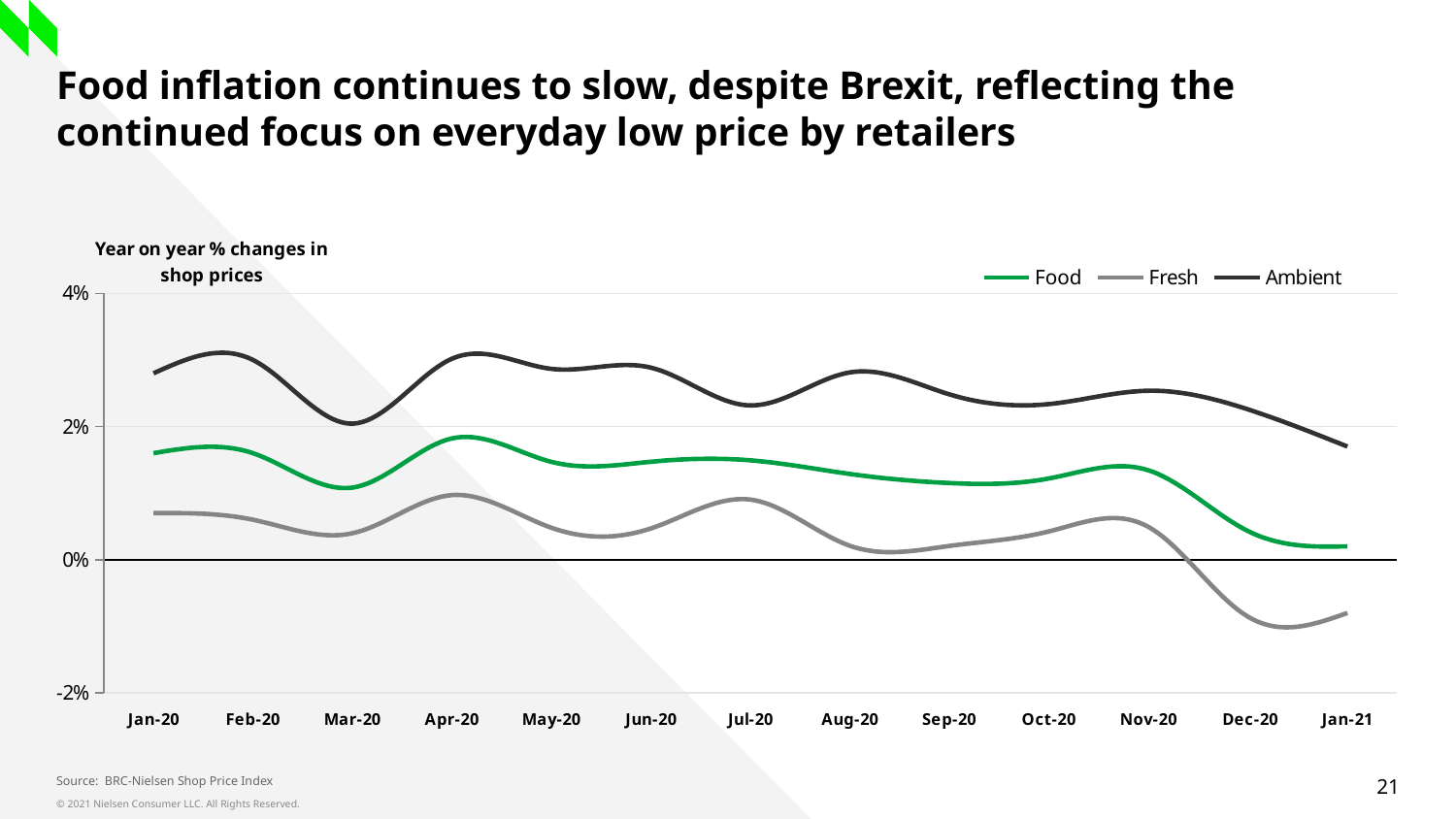
Is the value for Ambient in Jan-20 greater or less than 2%? greater In Dec-20, which is larger, the Food value or the Fresh value? Food Which series has the highest values across the whole period? Ambient What kind of chart is shown on the slide? Line chart Is the value for Food in Jan-21 greater or less than 2%? less In which month does the Fresh series reach its lowest value? Dec-20 Is the value for Fresh in Dec-20 greater or less than 0%? less Does the Food series rise or fall from Nov-20 to Jan-21? Fall How many series does the legend list? 3 Which series is plotted with the green line? Food What is the title of the chart's vertical axis label? Year on year % changes in shop prices How many months are shown along the x axis? 13